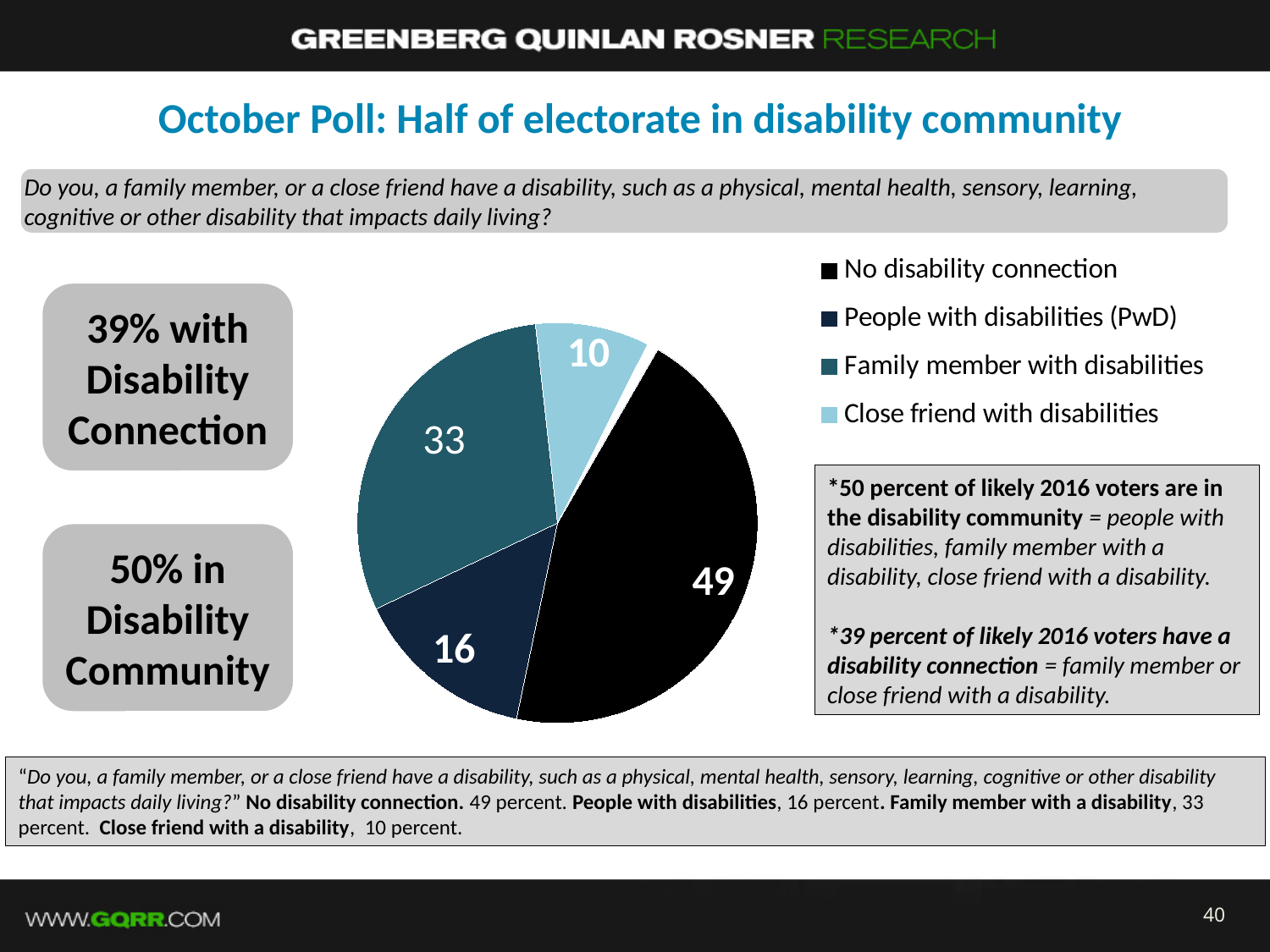
Which category has the largest slice? No disability connection What is the value for People with disabilities (PwD)? 16 What colour is the slice for No disability connection? black What kind of chart is shown on the slide? pie chart How many entries does the legend list? 4 Which is larger, the value for People with disabilities (PwD) or the value for Family member with disabilities? Family member with disabilities What is the value for Close friend with disabilities? 10 What is the value for Family member with disabilities? 33 What is the difference between the values for No disability connection and Family member with disabilities? 16 What is the value for No disability connection? 49